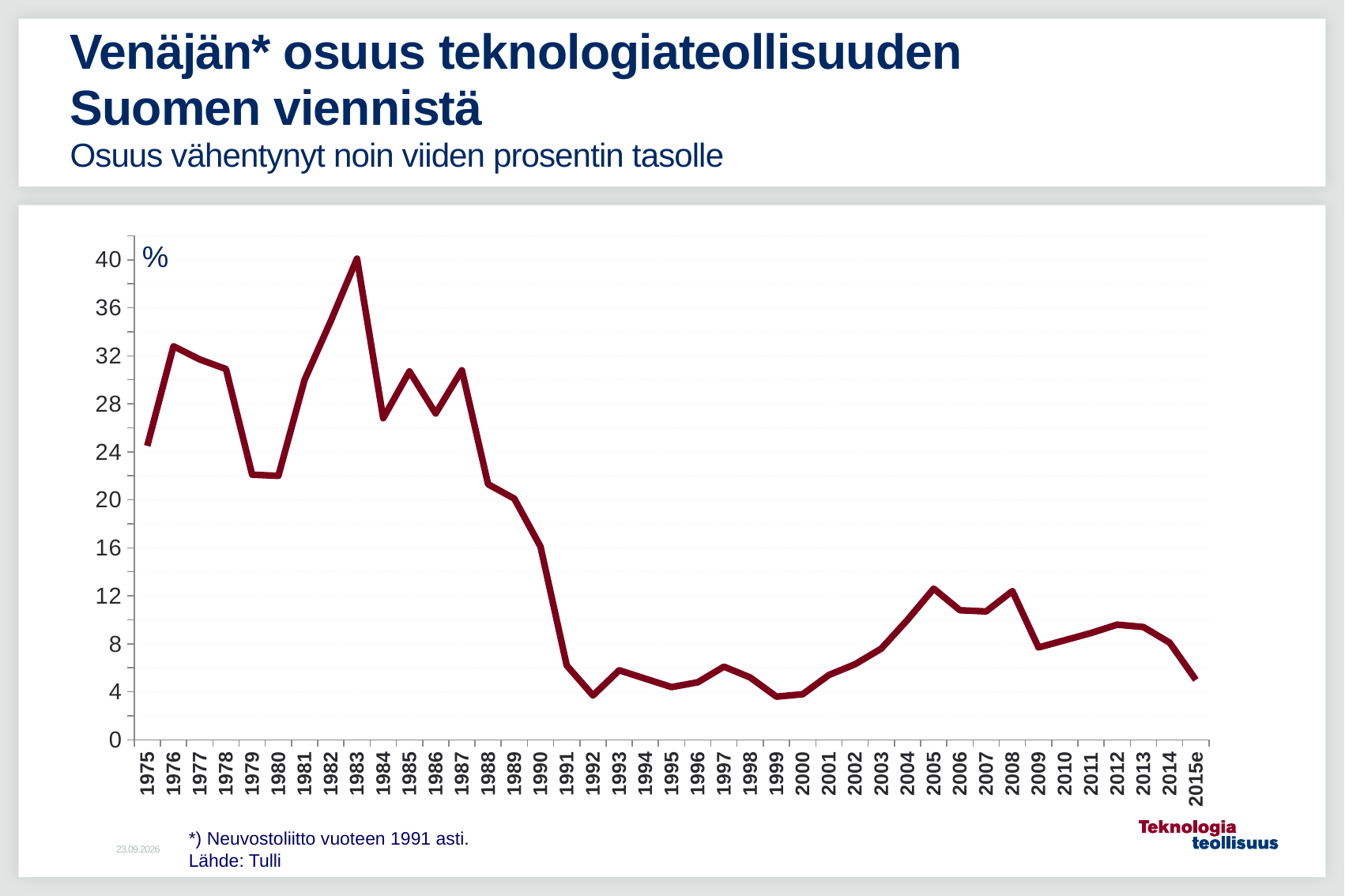
In which year does the line reach its highest value? 1983 How many years are plotted along the x axis? 41 Which year has the larger value, 1975 or 1976? 1976 Is the value for 1991 greater or less than 8? less Is the value for 1979 greater or less than 20? greater Is the value for 1983 greater or less than 36? greater Which year has the larger value, 2008 or 2009? 2008 What kind of chart is shown on the slide? line chart What unit is shown on the y axis? % Does the line rise or fall between 1983 and 1992? fall